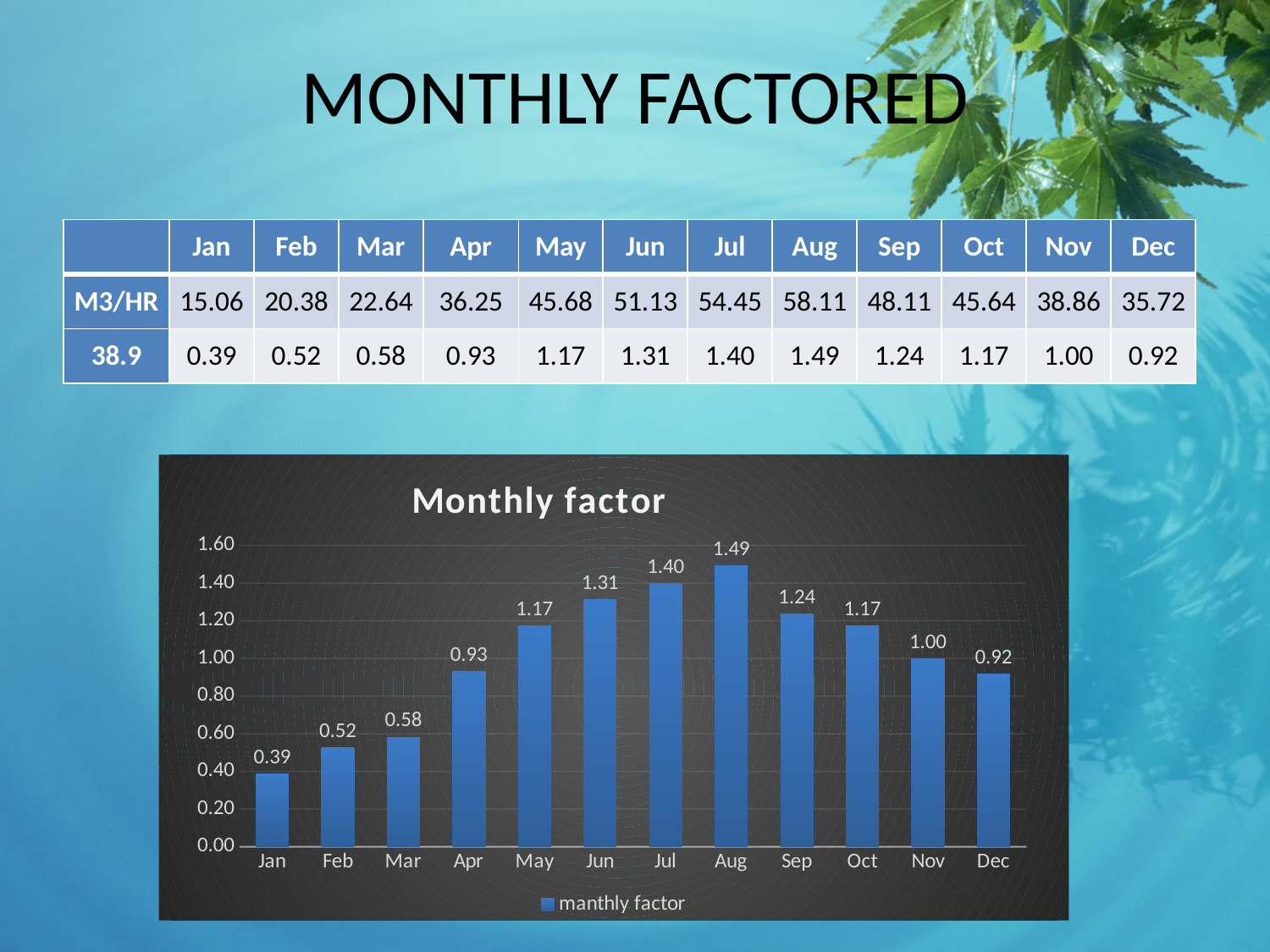
What is the title of the chart? Monthly factor Do the monthly factor values rise or fall from Jan to Aug in the chart? rise Which is larger in the chart, the monthly factor for Jun or for Sep? Jun What is the difference between the monthly factor for Aug and the monthly factor for Jan? 1.10 How many months are shown on the x axis of the chart? 12 What is the monthly factor for Jan in the chart? 0.39 Which month has the highest monthly factor in the chart? Aug Which month has the lowest monthly factor in the chart? Jan How many series does the chart legend list? 1 What is the monthly factor for Aug in the chart? 1.49 What kind of chart is shown on the slide? bar chart Is the monthly factor for Apr greater or less than 1.00? less